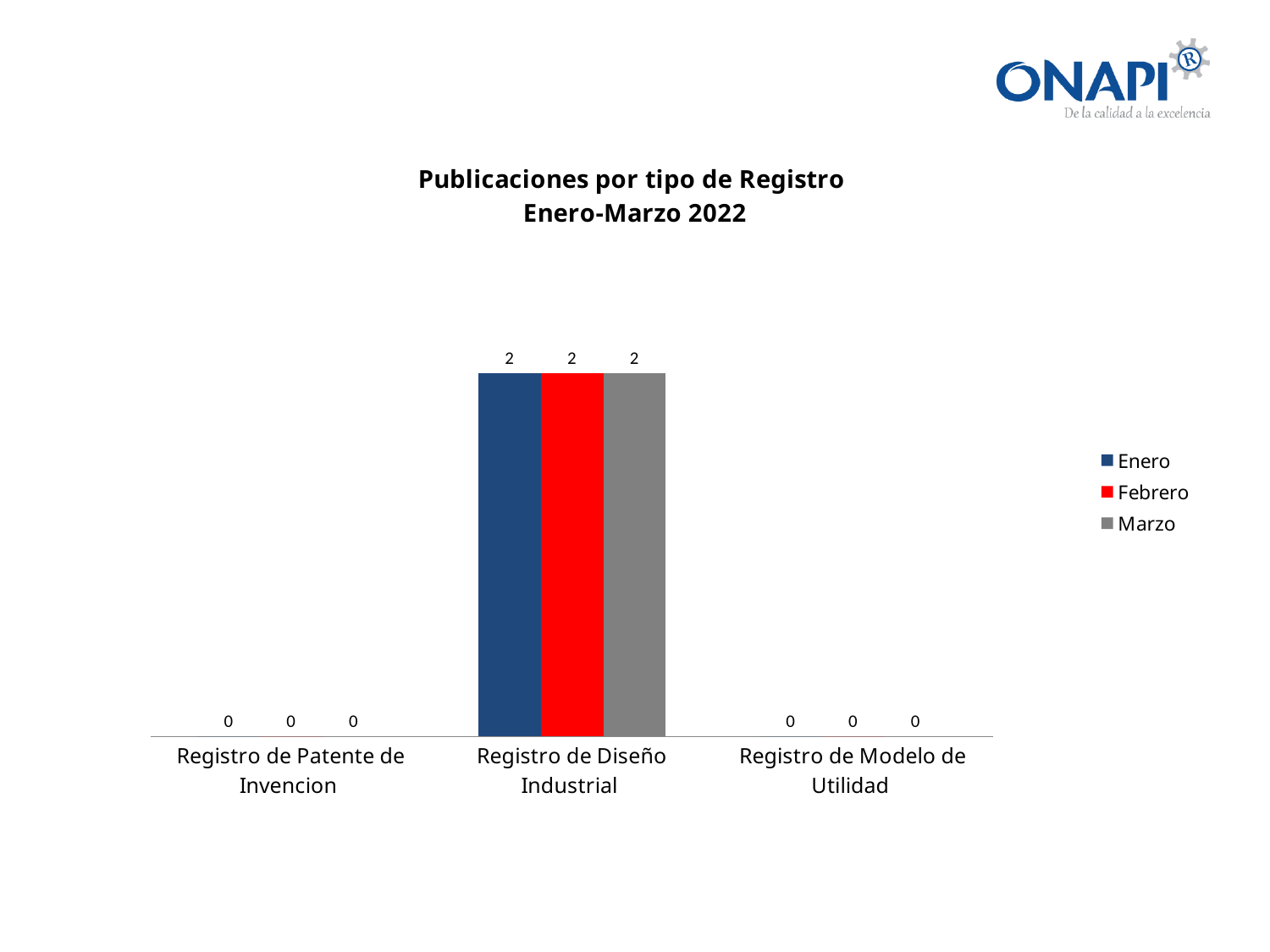
What kind of chart is shown on the slide? bar chart What is the total of the three monthly values for Registro de Diseño Industrial? 6 What is the value for Enero in Registro de Diseño Industrial? 2 What is the value for Marzo in Registro de Patente de Invencion? 0 What is the difference between the Febrero value for Registro de Diseño Industrial and the Febrero value for Registro de Patente de Invencion? 2 Which is larger: the Marzo value for Registro de Diseño Industrial or the Marzo value for Registro de Modelo de Utilidad? Registro de Diseño Industrial What is the value for Febrero in Registro de Modelo de Utilidad? 0 How many categories are shown on the x axis? 3 Which series is shown in red in the legend? Febrero What is the title of the chart? Publicaciones por tipo de Registro Enero-Marzo 2022 How many series does the legend list? 3 Which category has the highest values across all three months? Registro de Diseño Industrial